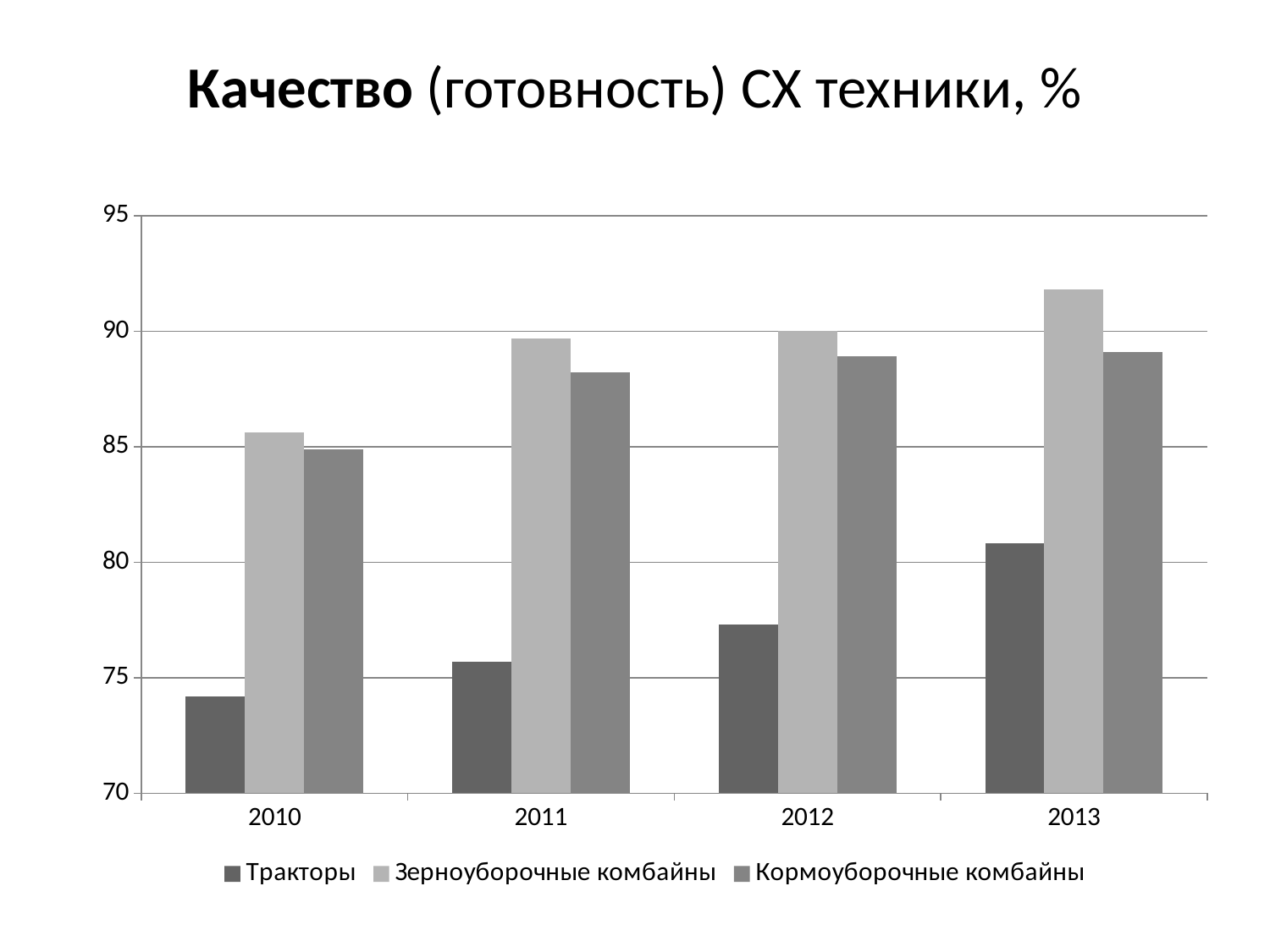
Do the values for Тракторы rise or fall from 2010 to 2013? rise How many series does the legend list? 3 What kind of chart is shown on the slide? bar chart How many years are shown along the x axis? 4 What is the title of the chart? Качество (готовность) СХ техники, % Which year has the lowest value for Тракторы? 2010 Is the value for Тракторы in 2010 greater or less than 75? less Which year has the highest value for Зерноуборочные комбайны? 2013 Which series has the lowest values in every year? Тракторы In 2011, which is larger: Зерноуборочные комбайны or Кормоуборочные комбайны? Зерноуборочные комбайны Is the value for Тракторы in 2013 greater or less than 80? greater